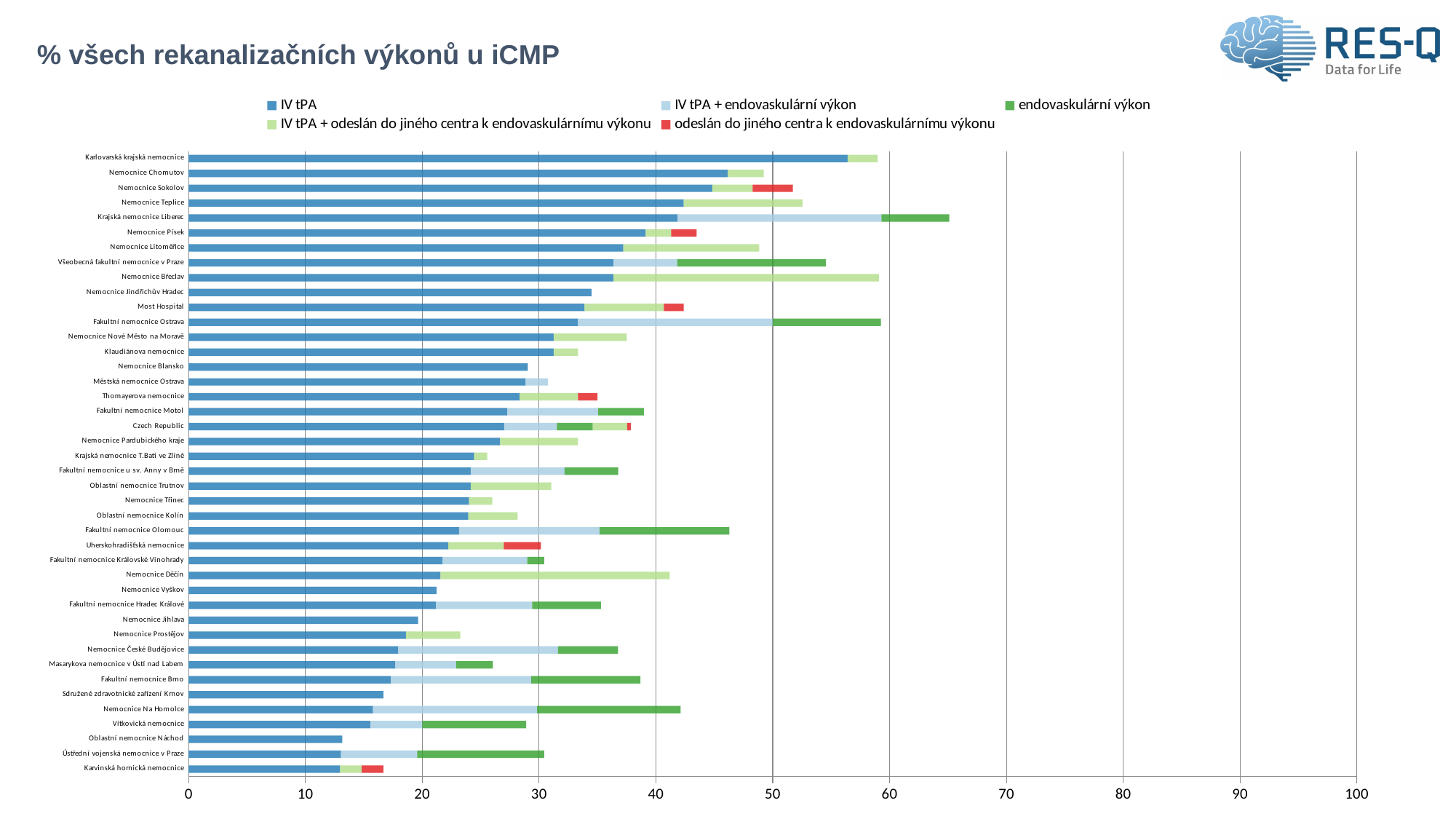
What is the title of the chart? % všech rekanalizačních výkonů u iCMP Which series is shown in red in the legend? odeslán do jiného centra k endovaskulárnímu výkonu Which category has the shortest total stacked bar? Oblastní nemocnice Náchod Which category has the highest IV tPA value? Karlovarská krajská nemocnice Which category has the longest total stacked bar? Krajská nemocnice Liberec What kind of chart is shown on the slide? bar chart How many series does the legend list? 5 Is the total bar for Fakultní nemocnice Olomouc greater or less than 40? greater How many hospitals/categories are plotted on the chart? 42 Which has the larger IV tPA value, Karlovarská krajská nemocnice or Nemocnice Chomutov? Karlovarská krajská nemocnice Is the IV tPA value for Karlovarská krajská nemocnice greater or less than 50? greater